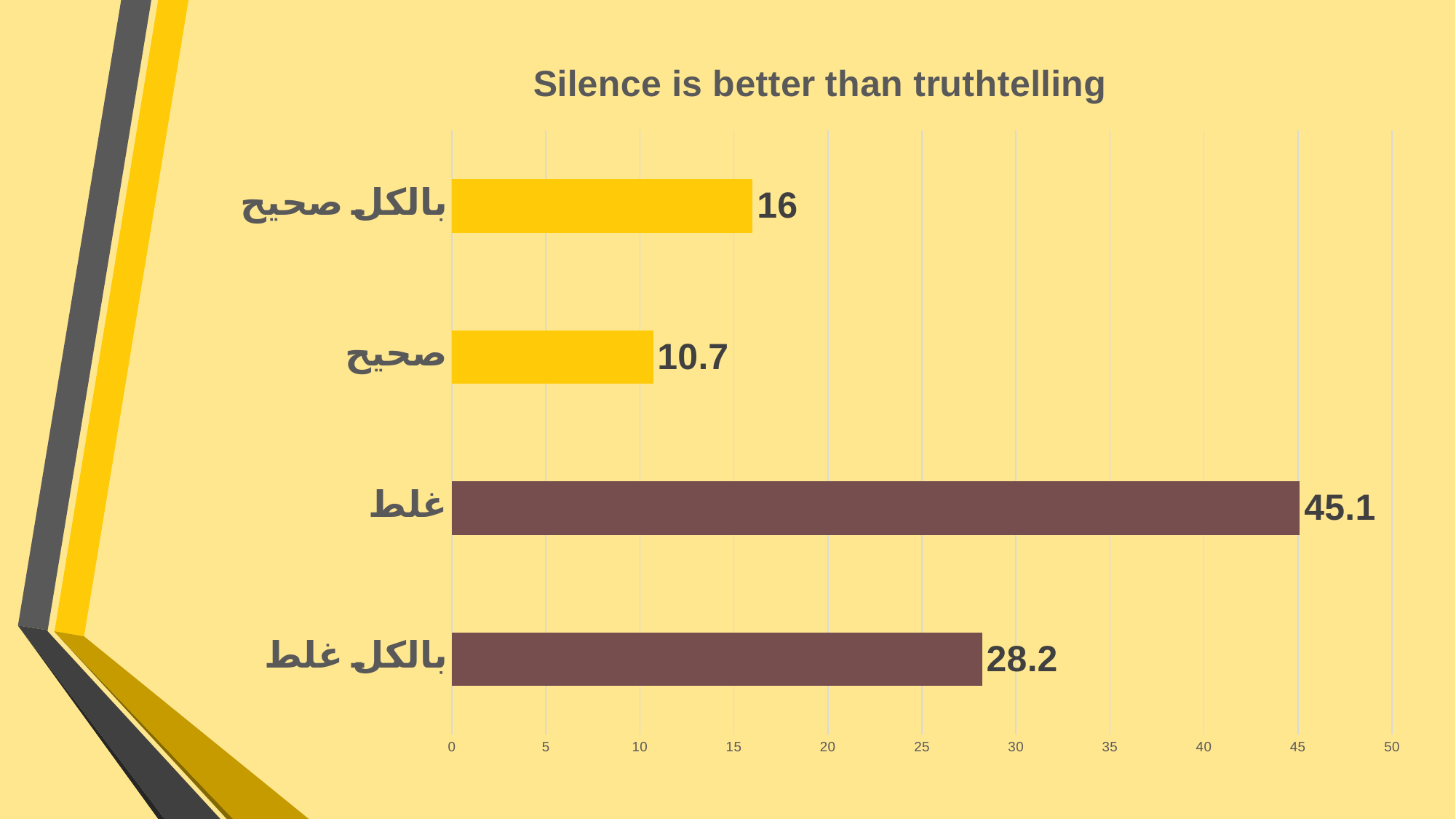
What is the difference between the values for بالكل صحيح and صحيح? 5.3 What is the value for غلط? 45.1 What is the value for صحيح? 10.7 What is the value for بالكل غلط? 28.2 What is the value for بالكل صحيح? 16 Which category has the highest value? غلط Which category has the lowest value? صحيح How many categories are shown in the chart? 4 Which is larger, the value for بالكل صحيح or the value for بالكل غلط? بالكل غلط What is the difference between the values for غلط and بالكل غلط? 16.9 What is the title of the chart? Silence is better than truthtelling What kind of chart is shown on the slide? bar chart